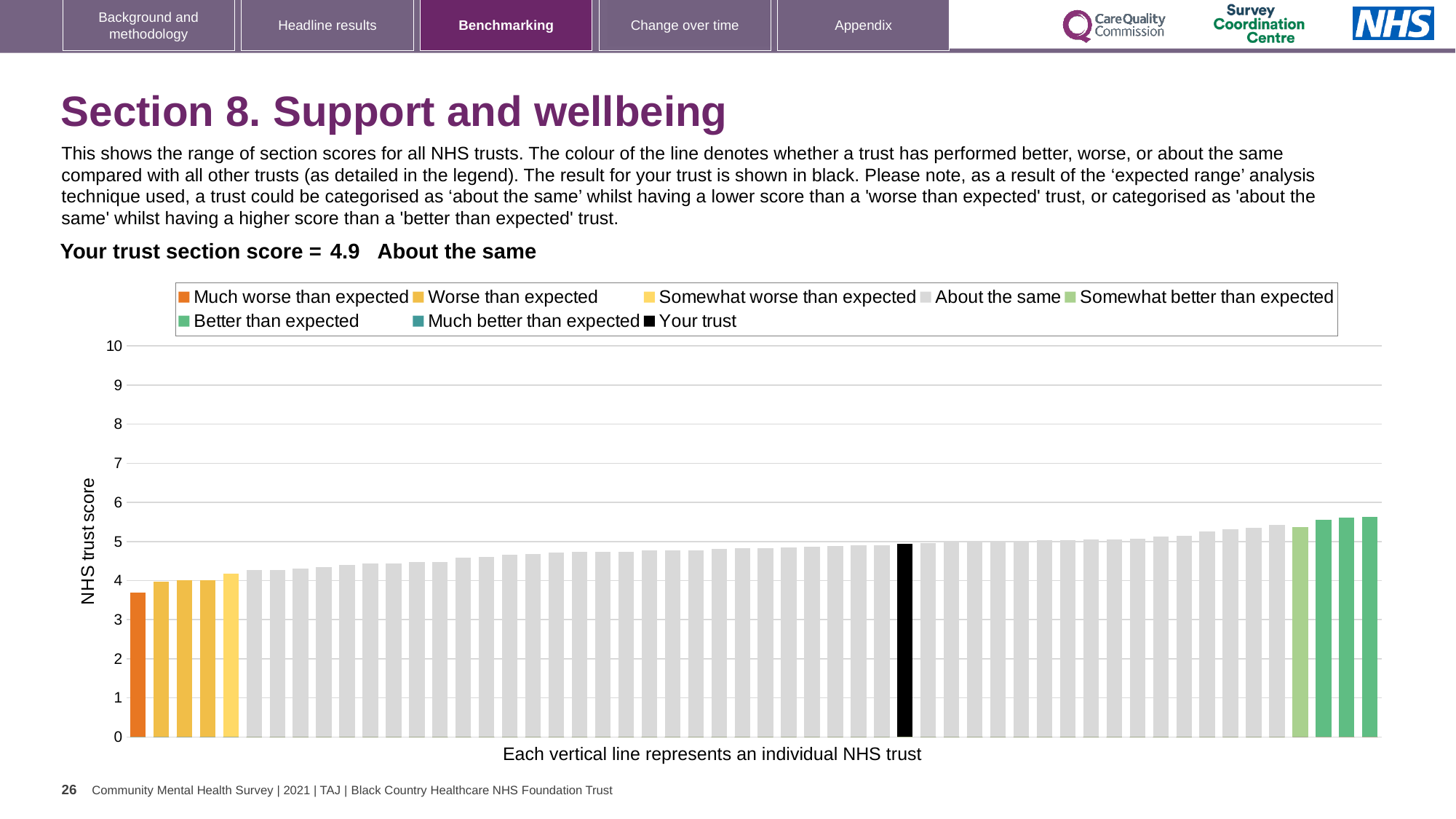
How many bars are coloured orange (Much worse than expected)? 1 Do the bar values rise or fall from left to right along the x axis? rise Which performance category is your trust placed in, according to the text above the chart? About the same What is the label on the y axis of the chart? NHS trust score Is the value of the highest bar on the chart greater or less than 6? less How many entries does the chart legend list? 8 What is the section score for your trust shown on the slide? 4.9 What colour is used for the bar representing your trust? black Is the value of the lowest bar on the chart greater or less than 3? greater Is the value for your trust (the black bar) greater or less than 4? greater What kind of chart is shown on the slide? bar chart